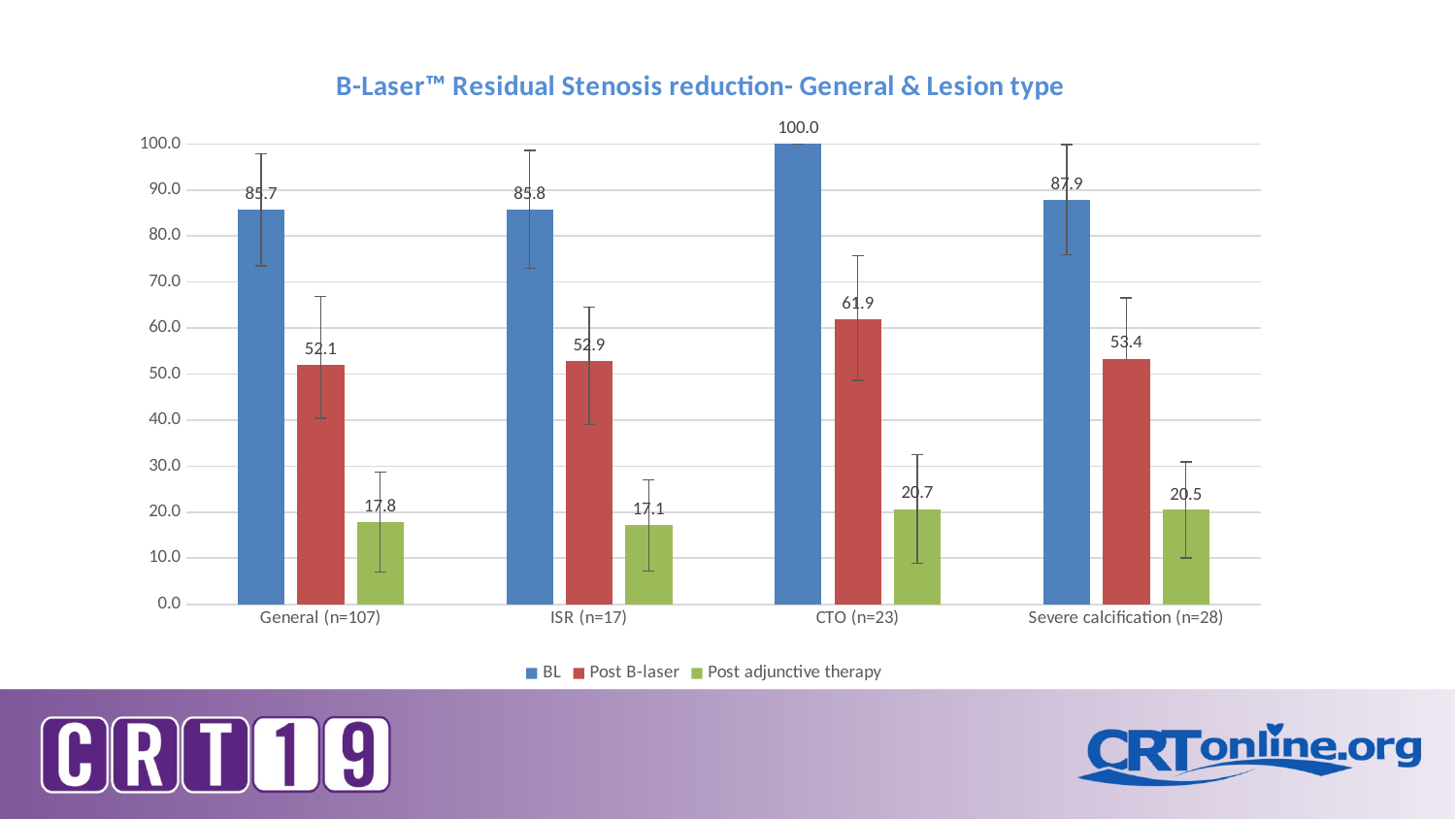
What kind of chart is shown on the slide? Bar chart Which category has the lowest Post adjunctive therapy value? ISR (n=17) What is the BL value for CTO (n=23)? 100.0 What is the Post adjunctive therapy value for ISR (n=17)? 17.1 What is the Post B-laser value for Severe calcification (n=28)? 53.4 How many categories are shown on the x axis? 4 How many series does the legend list? 3 What is the title of the chart? B-Laser™ Residual Stenosis reduction- General & Lesion type What is the Post B-laser value for General (n=107)? 52.1 Which is larger, the Post adjunctive therapy value for CTO (n=23) or for Severe calcification (n=28)? CTO (n=23) Which category has the highest Post B-laser value? CTO (n=23) What is the difference between the BL and Post B-laser values for CTO (n=23)? 38.1